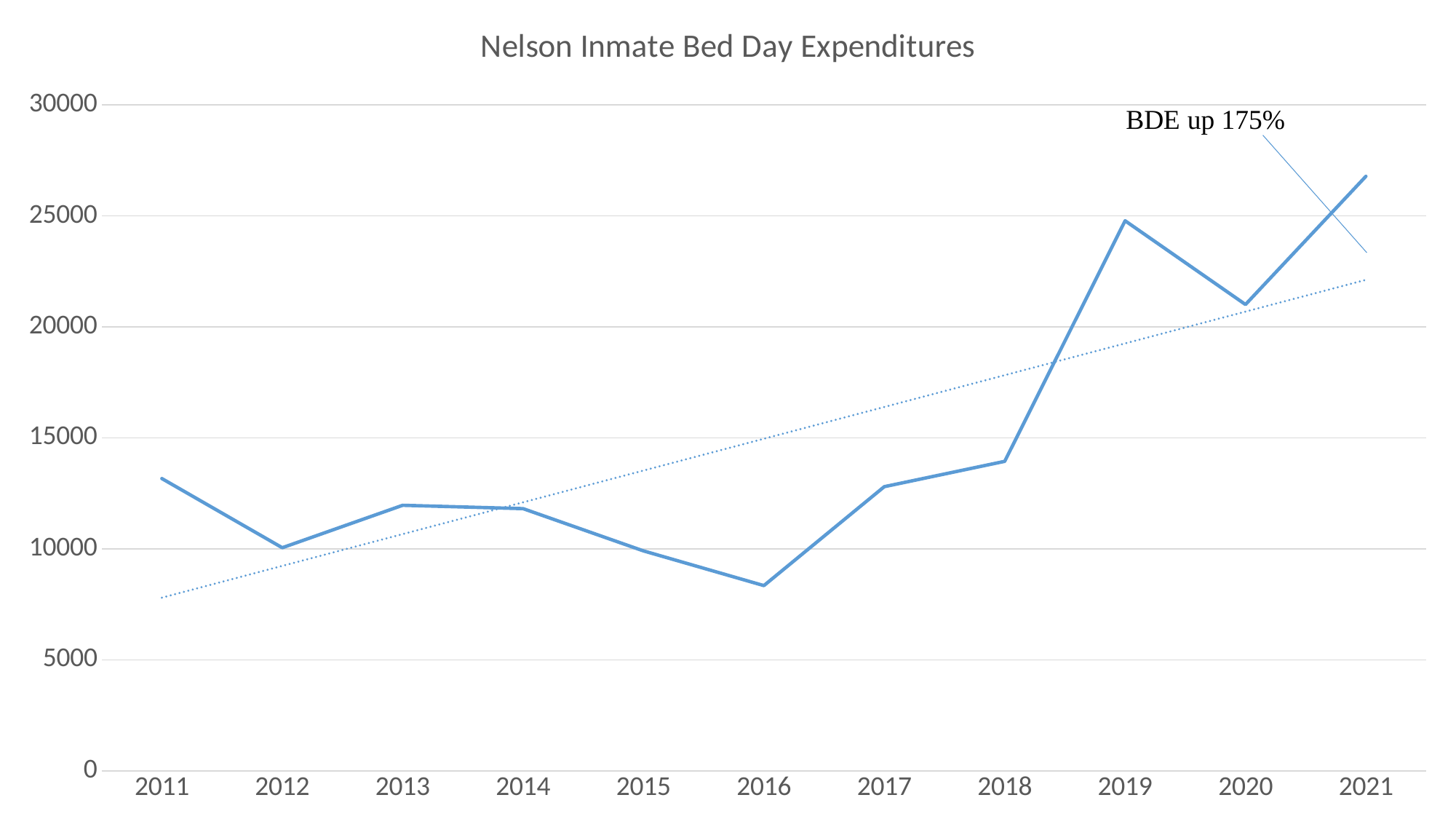
Is the value for 2016 greater or less than 10000? less Which is larger, the value for 2019 or the value for 2020? 2019 Which year has the highest value? 2021 Which is larger, the value for 2011 or the value for 2012? 2011 Is the value for 2021 greater or less than 25000? greater Is the value for 2018 greater or less than 15000? less What does the annotation text on the chart say? BDE up 175% Which year has the lowest value? 2016 What kind of chart is shown on the slide? line chart What is the title of the chart? Nelson Inmate Bed Day Expenditures How many years are plotted along the x axis? 11